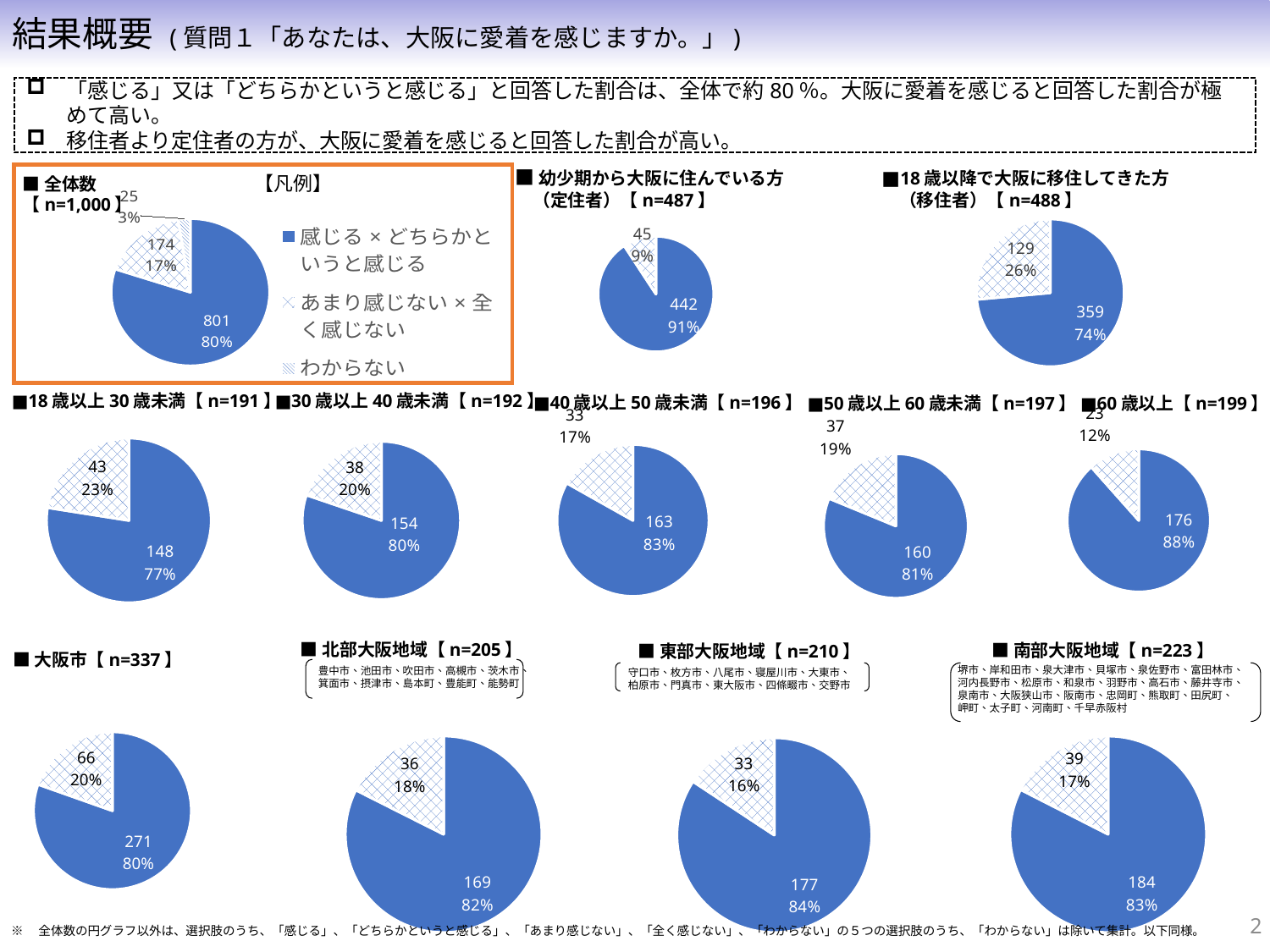
What is the difference in the number of 感じる × どちらかというと感じる respondents between the 定住者【n=487】 chart (442) and the 移住者【n=488】 chart (359)? 83 How many entries does the 【凡例】 legend list? 3 What type of chart is used for the 全体数【n=1,000】 data? Pie chart In the 東部大阪地域【n=210】 pie chart, what percentage answered 感じる × どちらかというと感じる? 84% In the 18歳以降で大阪に移住してきた方（移住者）【n=488】 pie chart, how many respondents answered あまり感じない × 全く感じない? 129 Among the five age-group pie charts (18歳以上30歳未満 to 60歳以上), which has the highest percentage of 感じる × どちらかというと感じる? 60歳以上【n=199】 In the 全体数【n=1,000】 pie chart, how many respondents answered 感じる × どちらかというと感じる? 801 Among the five age-group pie charts (18歳以上30歳未満 to 60歳以上), which has the lowest percentage of 感じる × どちらかというと感じる? 18歳以上30歳未満【n=191】 In the 幼少期から大阪に住んでいる方（定住者）【n=487】 pie chart, what percentage answered 感じる × どちらかというと感じる? 91% Which has the larger share of 感じる × どちらかというと感じる: the 定住者【n=487】 chart or the 移住者【n=488】 chart? 定住者【n=487】 In the 大阪市【n=337】 pie chart, how many respondents answered あまり感じない × 全く感じない? 66 In the 全体数【n=1,000】 pie chart, what percentage share does the わからない slice have? 3%